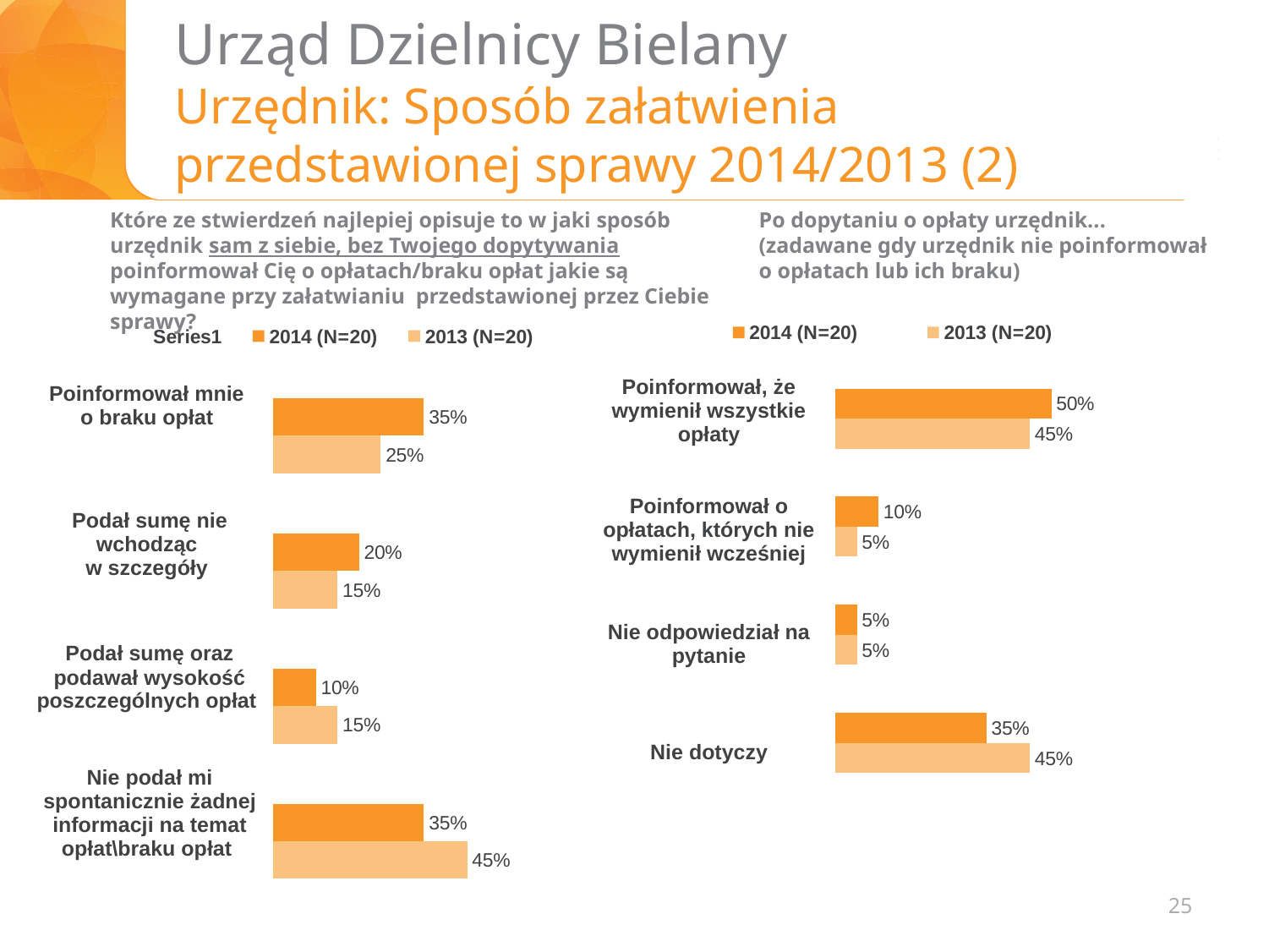
In the left chart, what is the 2013 value for 'Nie podał mi spontanicznie żadnej informacji na temat opłat\braku opłat'? 45% In the left chart, which category has the lowest 2014 value? Podał sumę oraz podawał wysokość poszczególnych opłat What type of chart is the right chart? bar chart In the right chart, is the 2014 value for 'Nie dotyczy' larger or smaller than its 2013 value? smaller In the right chart, what is the 2013 value for 'Nie dotyczy'? 45% In the right chart, what is the 2014 value for 'Poinformował, że wymienił wszystkie opłaty'? 50% In the left chart, what is the difference between the 2013 and 2014 values for 'Nie podał mi spontanicznie żadnej informacji na temat opłat\braku opłat'? 10% In the left chart, what is the 2014 value for 'Poinformował mnie o braku opłat'? 35% In the left chart, how many categories are shown? 4 In the right chart, which category has the highest 2014 value? Poinformował, że wymienił wszystkie opłaty In the left chart, what is the 2013 value for 'Podał sumę nie wchodząc w szczegóły'? 15% In the right chart, how many series does the legend list? 2